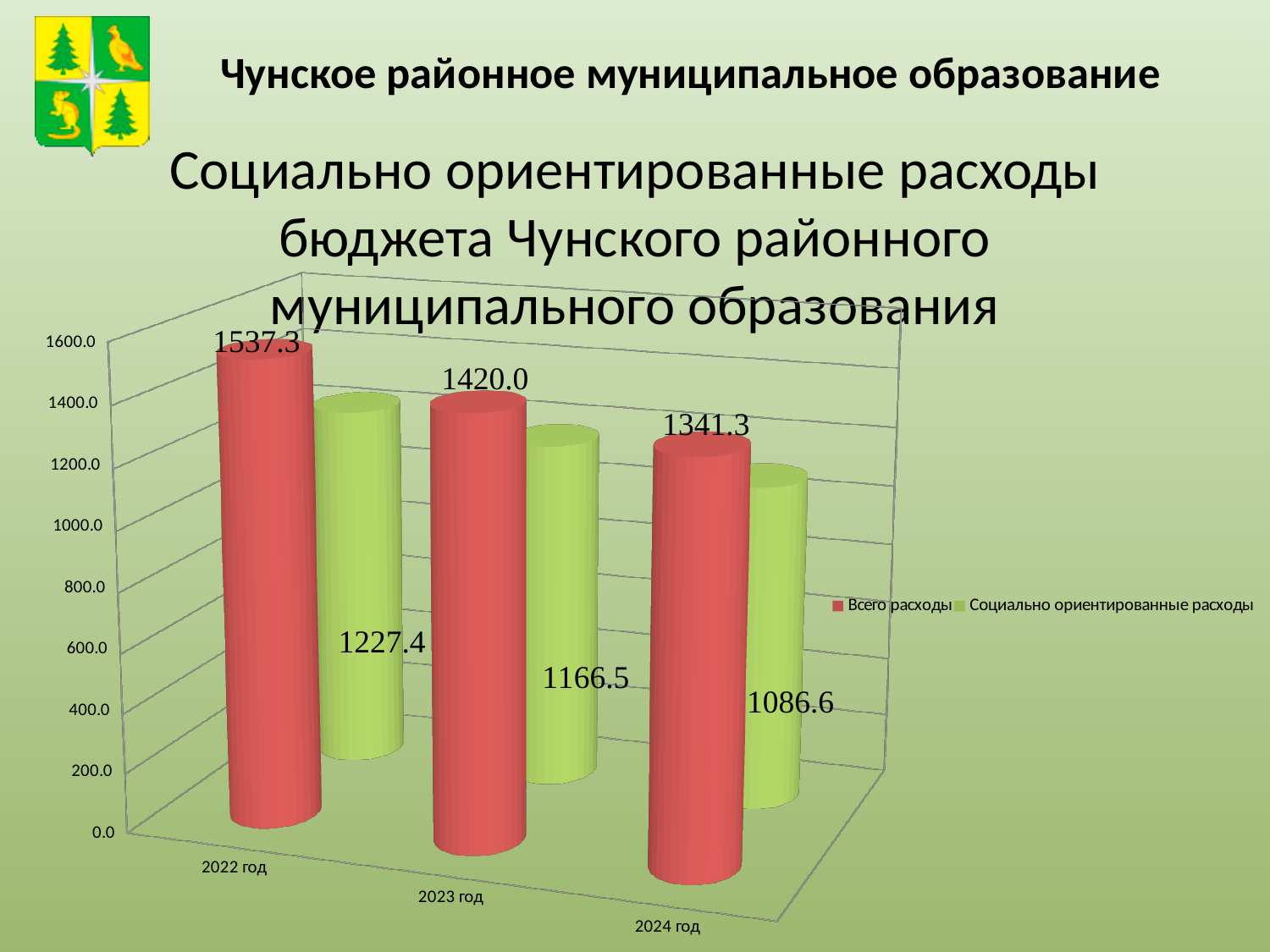
What is the value of "Социально ориентированные расходы" for 2024 год? 1086.6 In which year is "Всего расходы" the highest? 2022 год How many years are shown on the x axis of the chart? 3 What is the difference between "Всего расходы" and "Социально ориентированные расходы" in 2022 год? 309.9 What is the value of "Социально ориентированные расходы" for 2023 год? 1166.5 What is the value of "Всего расходы" for 2022 год? 1537.3 Do the values of "Всего расходы" rise or fall from 2022 год to 2024 год? Fall What is the value of "Всего расходы" for 2023 год? 1420.0 Which is larger: "Всего расходы" in 2024 год or "Социально ориентированные расходы" in 2022 год? Всего расходы in 2024 год How many series does the chart legend list? 2 In which year is "Социально ориентированные расходы" the lowest? 2024 год What kind of chart is shown on the slide? Bar chart